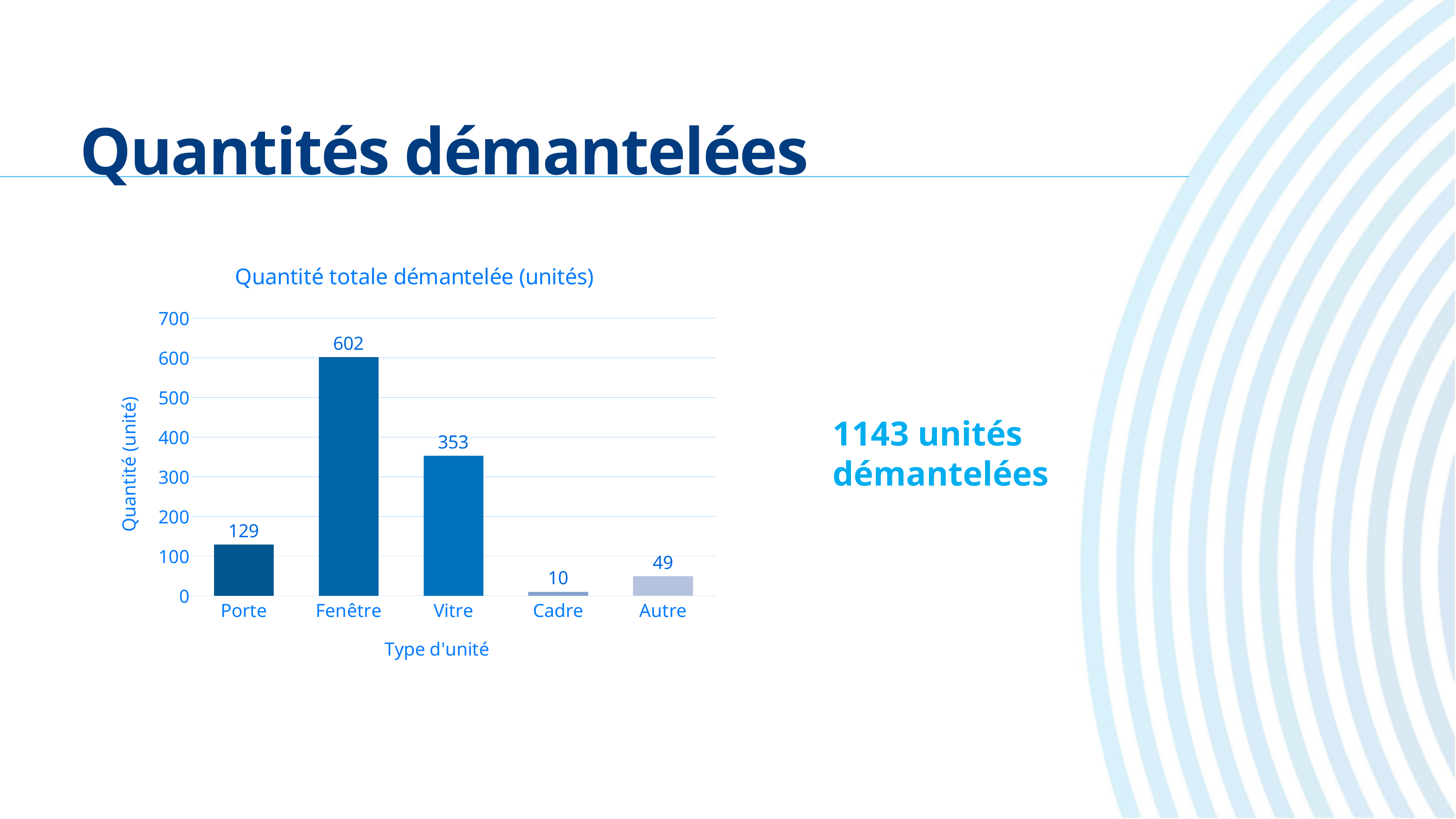
What kind of chart is shown on the slide? bar chart What is the title of the chart? Quantité totale démantelée (unités) Is the value for Vitre greater or less than 300? greater What is the difference between the values for Fenêtre and Vitre? 249 Which category has the lowest value? Cadre What is the value for Fenêtre? 602 What is the value for Porte? 129 Which category has the highest value? Fenêtre What is the value for Autre? 49 How many categories are shown on the x axis? 5 Which is larger, the value for Porte or the value for Autre? Porte What is the value for Cadre? 10